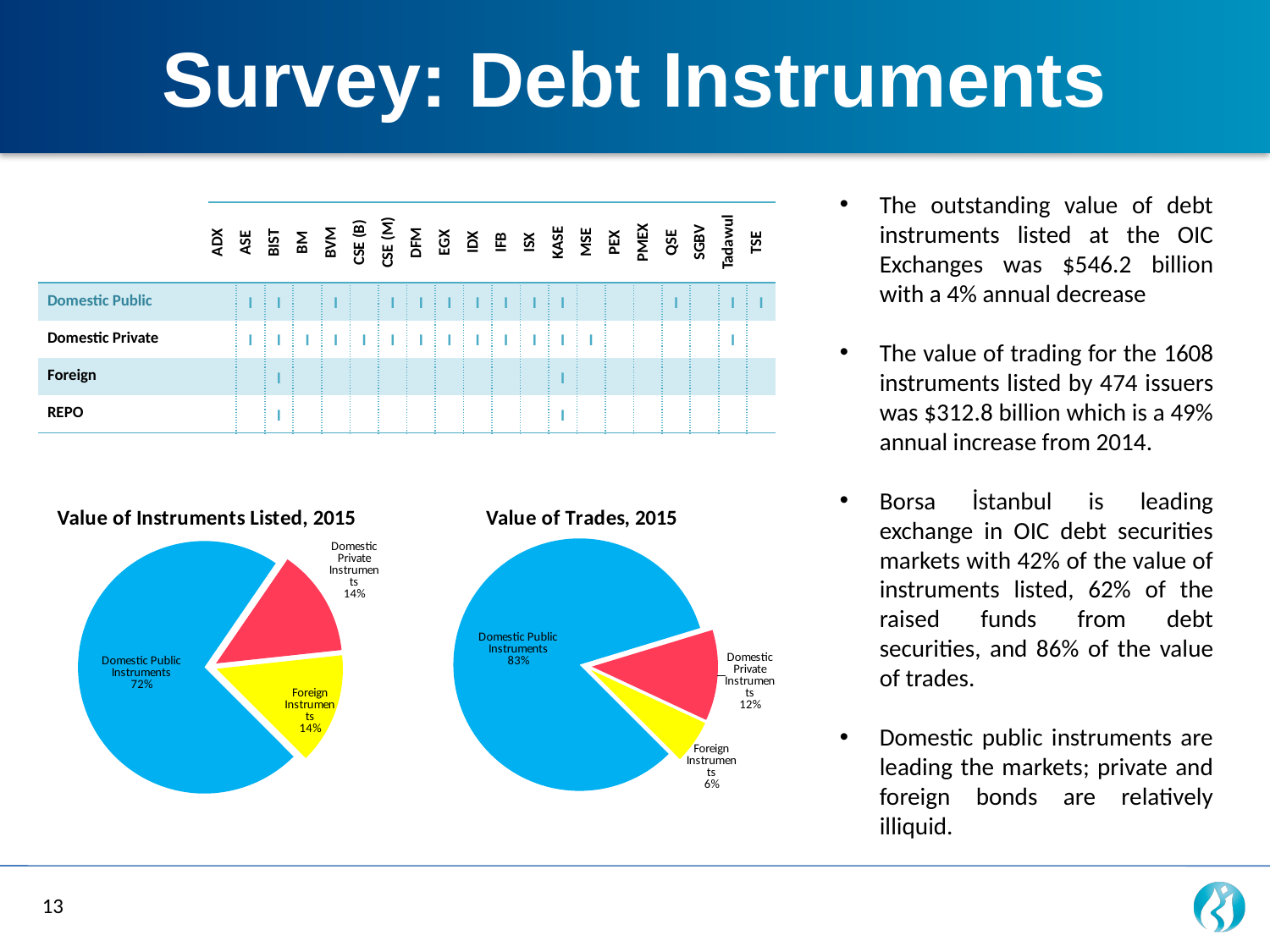
How many slices does the 'Value of Trades, 2015' pie chart have? 3 In the 'Value of Trades, 2015' chart, which is larger: Domestic Private Instruments or Foreign Instruments? Domestic Private Instruments In the 'Value of Trades, 2015' chart, what share do Foreign Instruments have? 6% In the 'Value of Trades, 2015' chart, what share do Domestic Private Instruments have? 12% In the 'Value of Instruments Listed, 2015' chart, what share do Foreign Instruments have? 14% In the 'Value of Trades, 2015' chart, which category has the smallest share? Foreign Instruments In the 'Value of Trades, 2015' chart, what is the difference between the Domestic Private Instruments share and the Foreign Instruments share? 6% What kind of chart is 'Value of Instruments Listed, 2015'? Pie chart In the 'Value of Instruments Listed, 2015' chart, what colour is the Foreign Instruments slice? Yellow In the 'Value of Trades, 2015' chart, what share do Domestic Public Instruments have? 83% In the 'Value of Instruments Listed, 2015' chart, which category has the largest share? Domestic Public Instruments In the 'Value of Instruments Listed, 2015' chart, what share do Domestic Public Instruments have? 72%